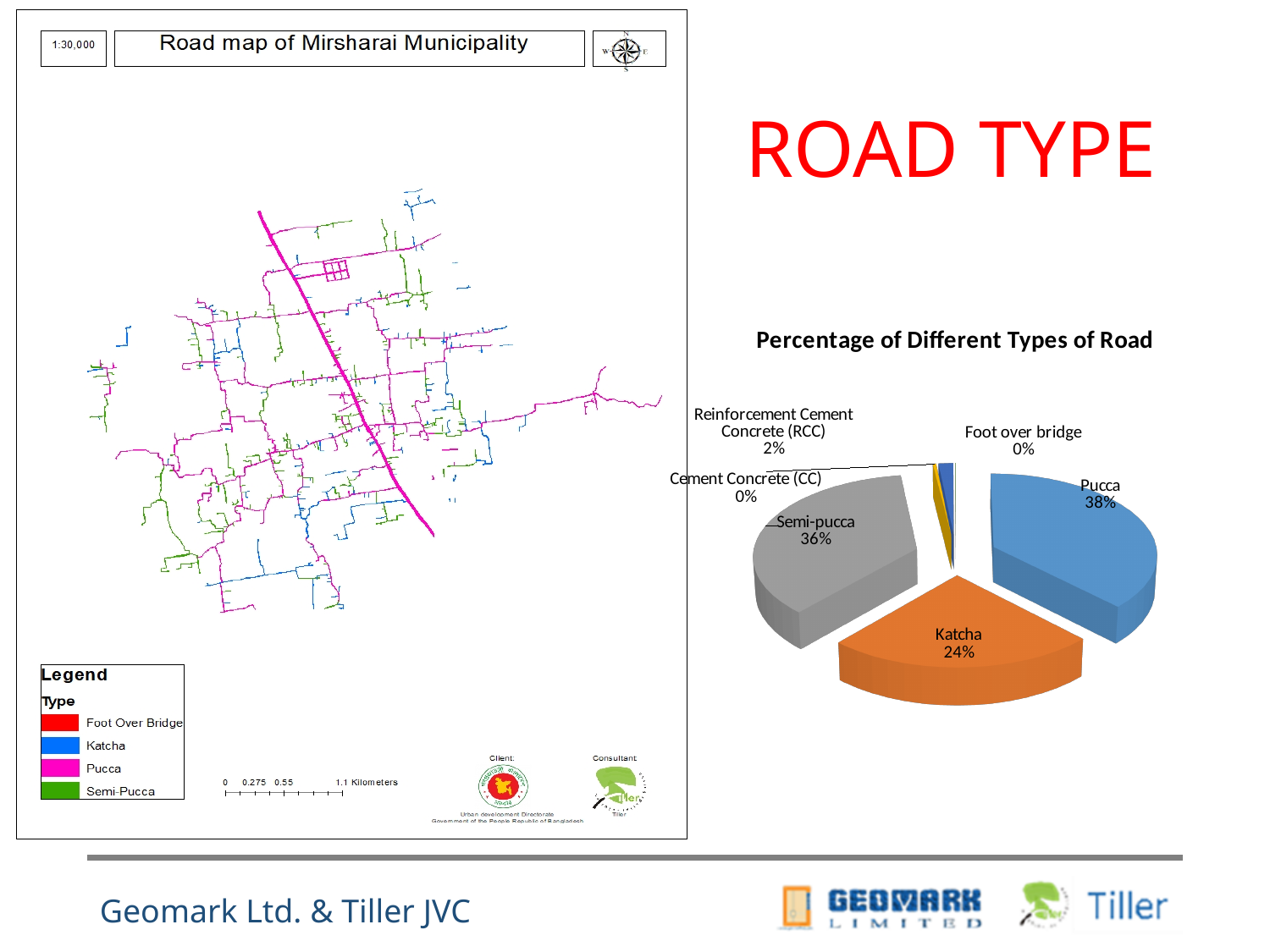
What is the percentage shown for Semi-pucca in the pie chart? 36% In the pie chart, what is the difference in percentage points between Pucca and Katcha? 14% How many road type categories are shown in the pie chart? 6 What is the title of the pie chart? Percentage of Different Types of Road What percentage of roads are Pucca according to the pie chart? 38% What percentage is shown for Reinforcement Cement Concrete (RCC) in the pie chart? 2% What percentage does the Katcha slice represent in the pie chart? 24% In the pie chart, which is larger: the share for Pucca or the share for Semi-pucca? Pucca In the pie chart, what is the difference in percentage points between Semi-pucca and Katcha? 12% What type of chart is shown under the title "Percentage of Different Types of Road"? Pie chart Which road type has the largest share in the pie chart? Pucca What percentage is shown for Foot over bridge in the pie chart? 0%